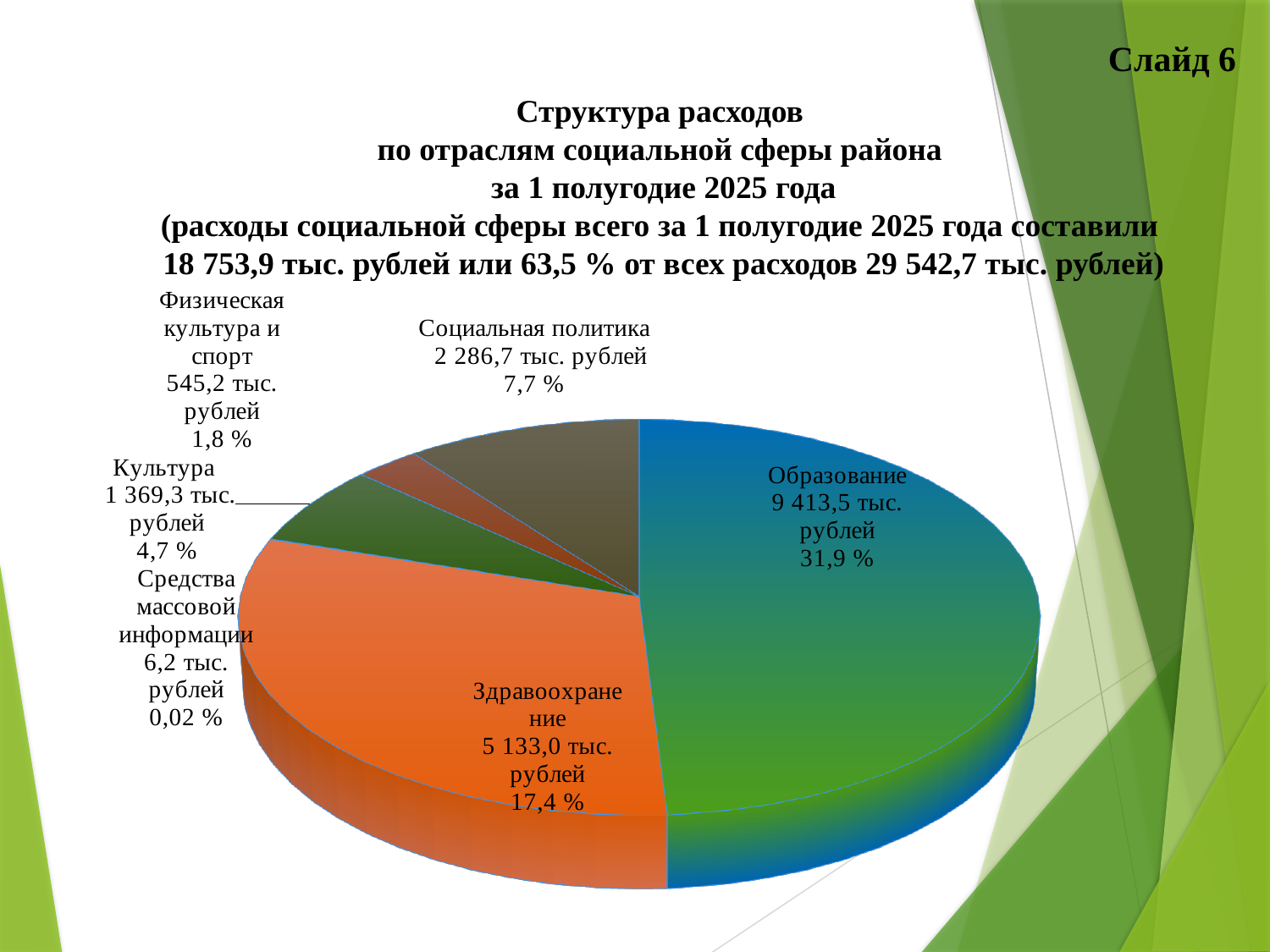
What is the difference between the values for Культура and Физическая культура и спорт? 824,1 тыс. рублей What is the value shown for Образование? 9 413,5 тыс. рублей What percentage is shown for Средства массовой информации? 0,02 % What kind of chart is shown on the slide? pie chart Which is larger, the value for Социальная политика or the value for Культура? Социальная политика What is the difference between the values for Образование and Здравоохранение? 4 280,5 тыс. рублей What percentage is shown for Социальная политика? 7,7 % How many slices does the pie chart have? 6 Which category has the smallest slice of the pie? Средства массовой информации What is the value shown for Здравоохранение? 5 133,0 тыс. рублей Which category has the largest slice of the pie? Образование What is the value shown for Культура? 1 369,3 тыс. рублей